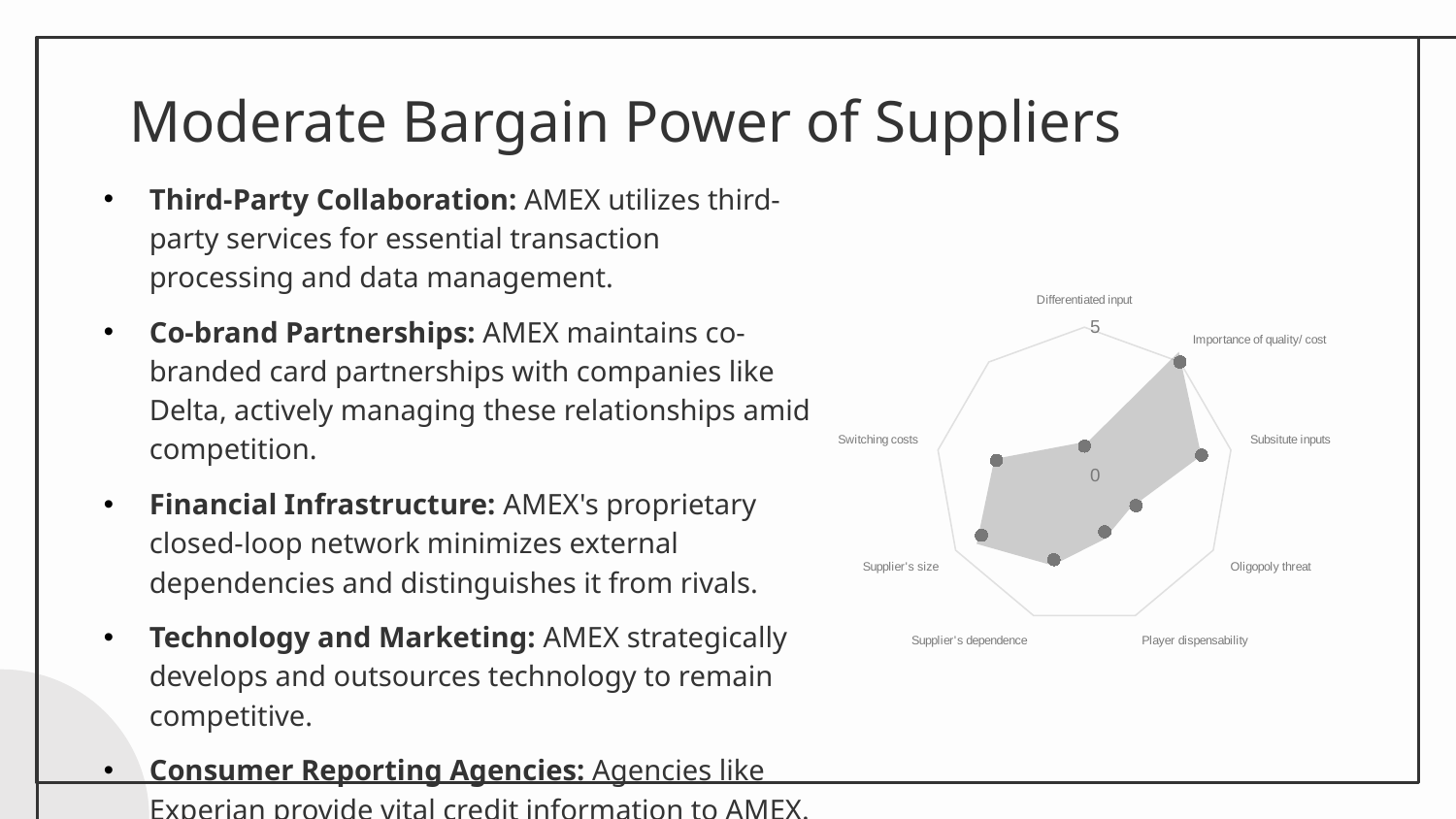
What is the maximum value shown on the radar chart's axis scale? 5 What kind of chart is shown on the slide? radar chart Is the value for Differentiated input on the radar chart greater or less than 5? less Which is larger on the radar chart, the value for Subsitute inputs or the value for Player dispensability? Subsitute inputs What is the minimum value shown on the radar chart's axis scale? 0 Which category has the lowest value on the radar chart? Differentiated input Which is larger on the radar chart, the value for Importance of quality/ cost or the value for Differentiated input? Importance of quality/ cost Which is larger on the radar chart, the value for Supplier's size or the value for Oligopoly threat? Supplier's size